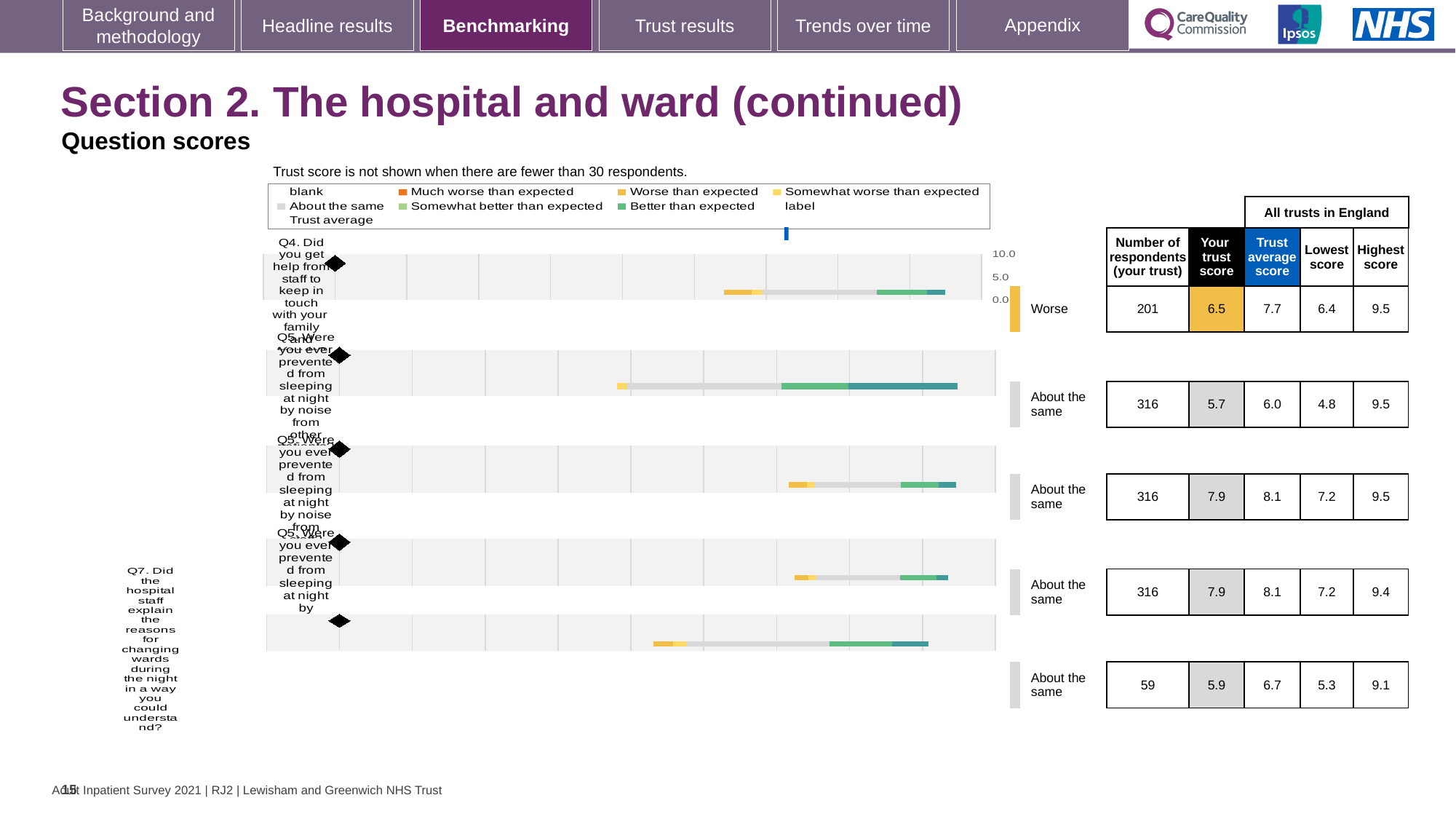
In the table beside the chart, what is the lowest score for the second row? 4.8 How many horizontal bars (question rows) are plotted in the chart? 5 In the table beside the chart, what is the highest score for the last row? 9.1 What kind of chart is shown on the slide? bar chart In the table beside the chart, what is the 'Your trust score' for the first row (rated 'Worse')? 6.5 For the first row (rated 'Worse'), what is the difference between the trust average score and the trust score? 1.2 What is the highest tick value shown on the chart's score axis? 10.0 For the first row (rated 'Worse'), which is larger: the trust score or the trust average score? Trust average score In the table beside the chart, what is the trust average score for the first row (rated 'Worse')? 7.7 Which legend entry is shown in orange in the chart legend? Much worse than expected Which row has the fewest respondents in the table beside the chart? The last row (59 respondents) In the table beside the chart, what is the number of respondents for the first row (rated 'Worse')? 201